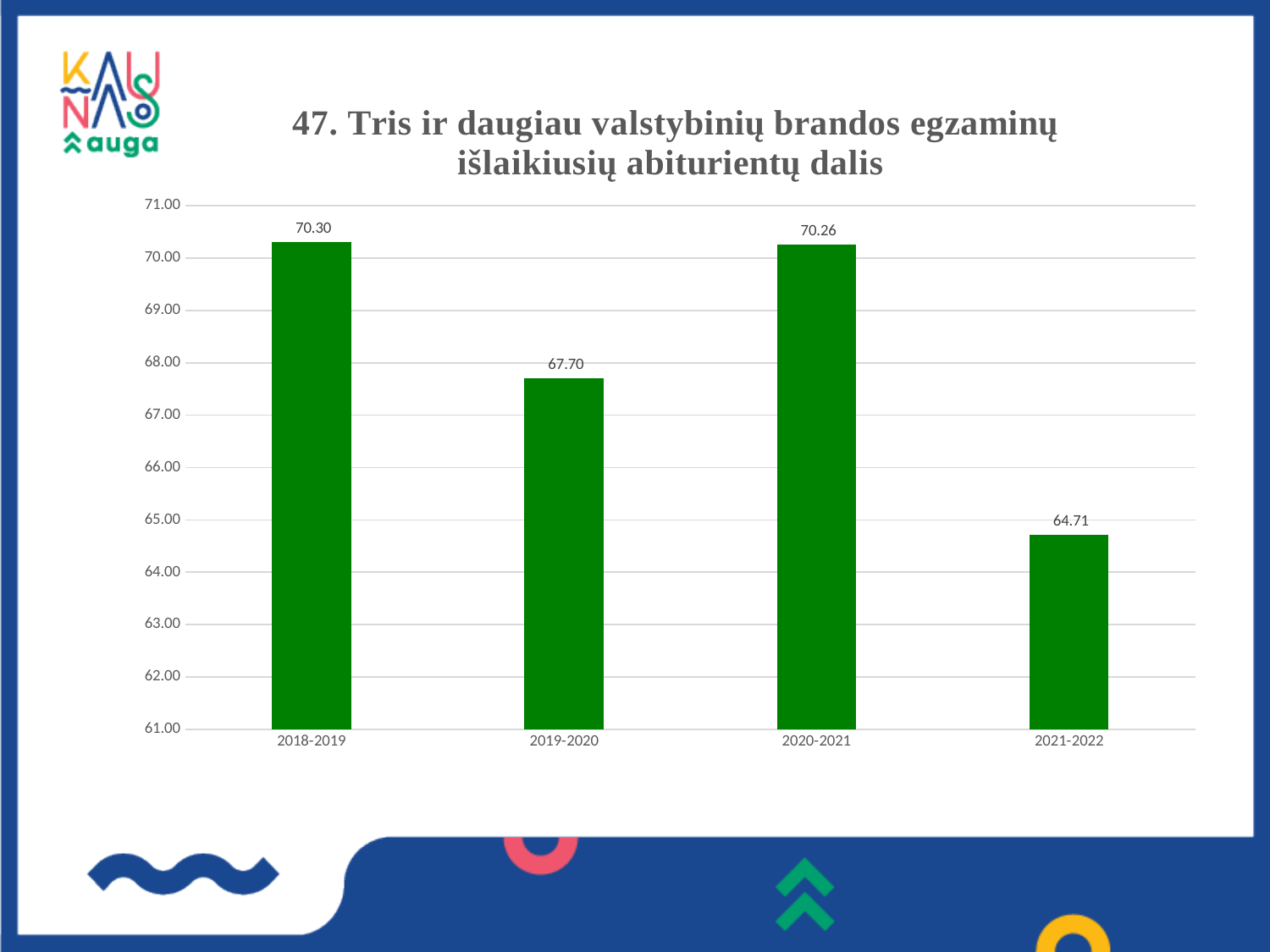
Which school year has the lowest value? 2021-2022 Which school year has the highest value? 2018-2019 How many school years are shown on the x axis? 4 What is the difference between the values for 2020-2021 and 2019-2020? 2.56 What is the difference between the values for 2018-2019 and 2021-2022? 5.59 Which is larger, the value for 2019-2020 or the value for 2021-2022? 2019-2020 What is the value for 2021-2022? 64.71 What kind of chart is shown on the slide? bar chart Is the value for 2021-2022 higher or lower than the value for 2018-2019? lower What is the value for 2019-2020? 67.70 Is the value for 2019-2020 greater or less than 68.00? less What is the value for 2018-2019? 70.30